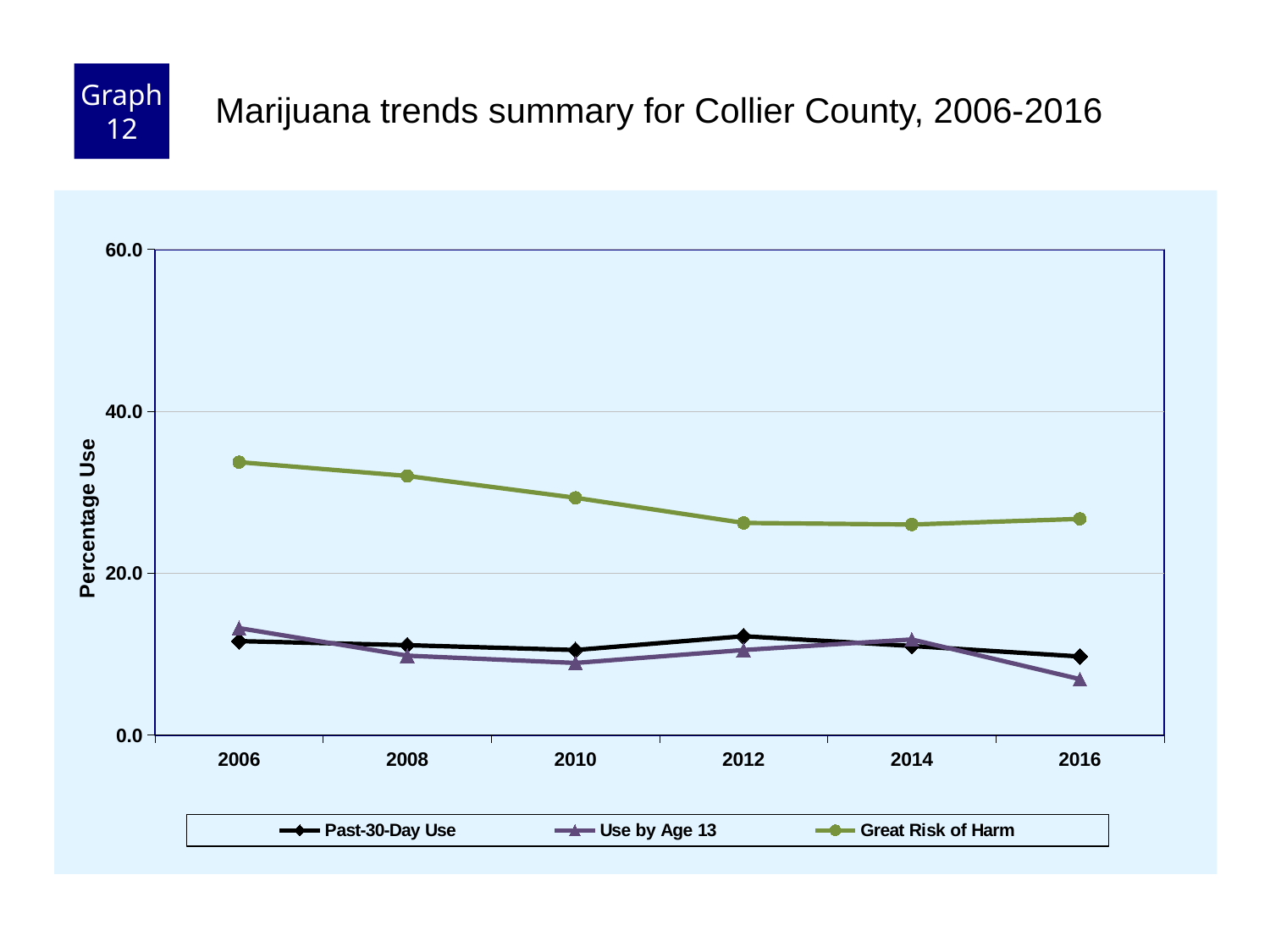
How many series does the legend list? 3 Is the Great Risk of Harm value for 2016 greater or less than 20.0? greater Which series has the highest values across all years? Great Risk of Harm How many years are plotted along the x axis? 6 Is the Great Risk of Harm value for 2006 greater or less than 40.0? less What is the label on the y axis? Percentage Use In which year is the Use by Age 13 value lowest? 2016 Does the Great Risk of Harm line rise or fall from 2006 to 2012? Fall What kind of chart is shown on the slide? Line chart In 2016, which is larger: Past-30-Day Use or Use by Age 13? Past-30-Day Use Is the Past-30-Day Use value for 2012 greater or less than 20.0? less In which year is the Great Risk of Harm value highest? 2006